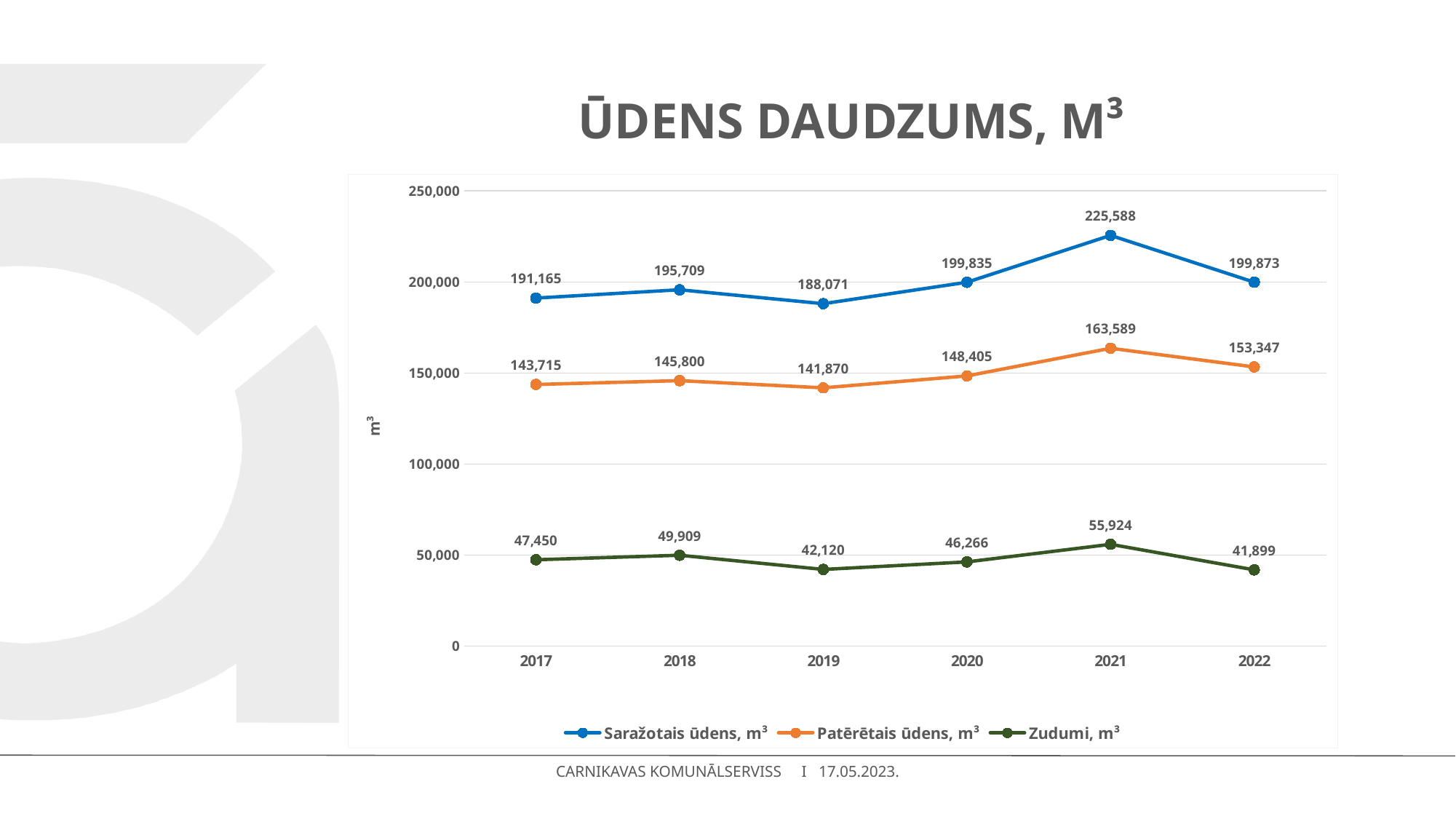
What is the difference between Saražotais ūdens, m³ and Patērētais ūdens, m³ in 2017? 47,450 In which year is Saražotais ūdens, m³ highest? 2021 What is the title of the chart? ŪDENS DAUDZUMS, M³ What is the value of Zudumi, m³ in 2022? 41,899 Is the value for Patērētais ūdens, m³ in 2021 greater or less than 150,000? greater In which year is Zudumi, m³ lowest? 2022 Which is larger: Zudumi, m³ in 2018 or Zudumi, m³ in 2020? 2018 What is the value of Patērētais ūdens, m³ in 2019? 141,870 What is the value of Saražotais ūdens, m³ in 2021? 225,588 What kind of chart is shown on the slide? line chart How many years are shown on the x axis? 6 How many series does the legend list? 3